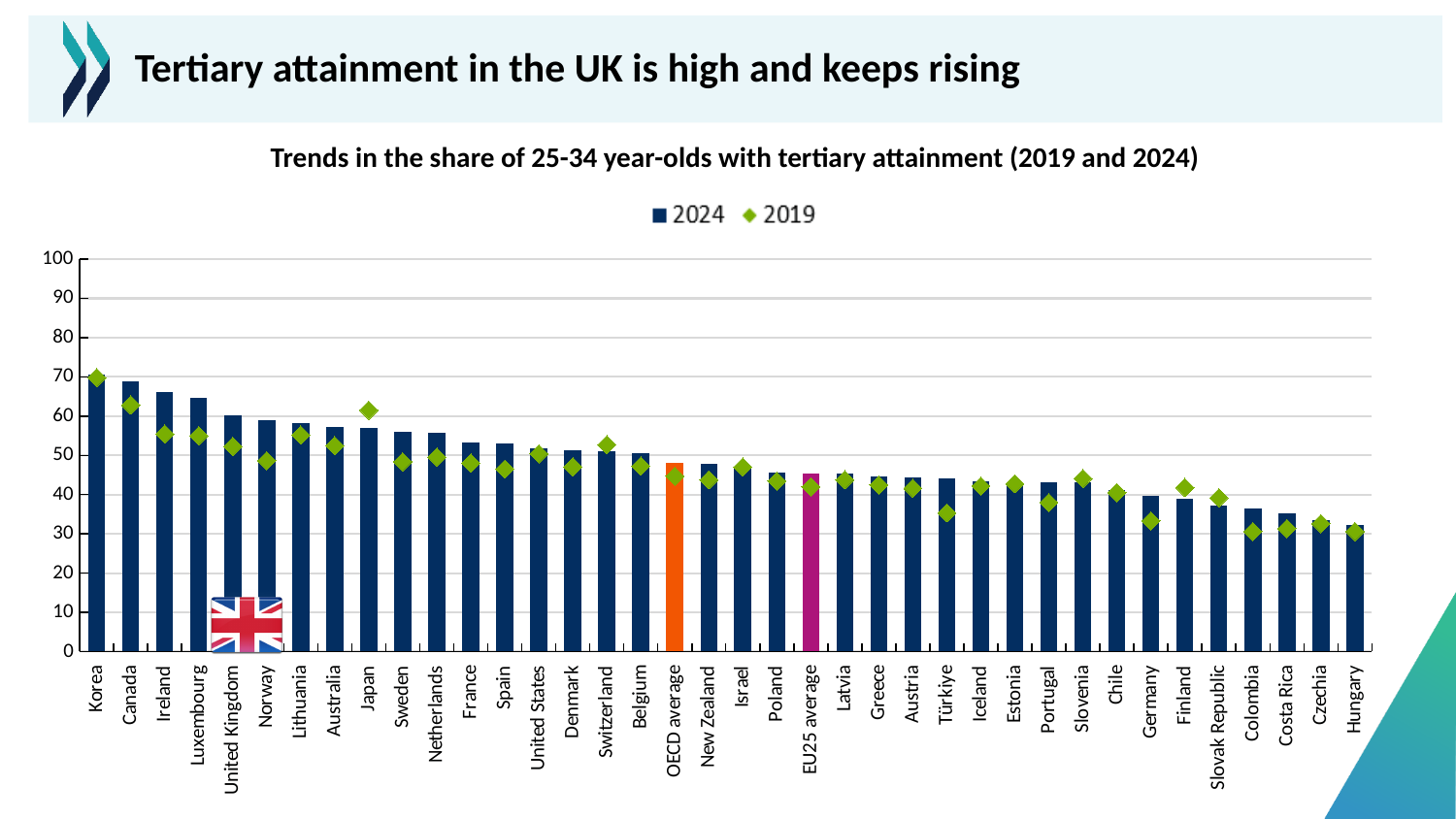
Do the 2024 values rise or fall moving from left to right along the x axis? fall How many series does the legend list? 2 Which two years are shown in the legend? 2024 and 2019 For Japan, which is higher: the 2019 value or the 2024 value? 2019 What kind of chart is shown on the slide? bar chart Which category has the lowest 2024 value? Hungary Is the 2024 value for Canada greater or less than 60? greater Is the 2024 value for the United Kingdom greater or less than 50? greater Which has a higher 2024 value, Canada or Ireland? Canada Is the 2024 value for Germany greater or less than 50? less Which category has the highest 2024 value? Korea How many countries or averages are shown along the x axis? 38